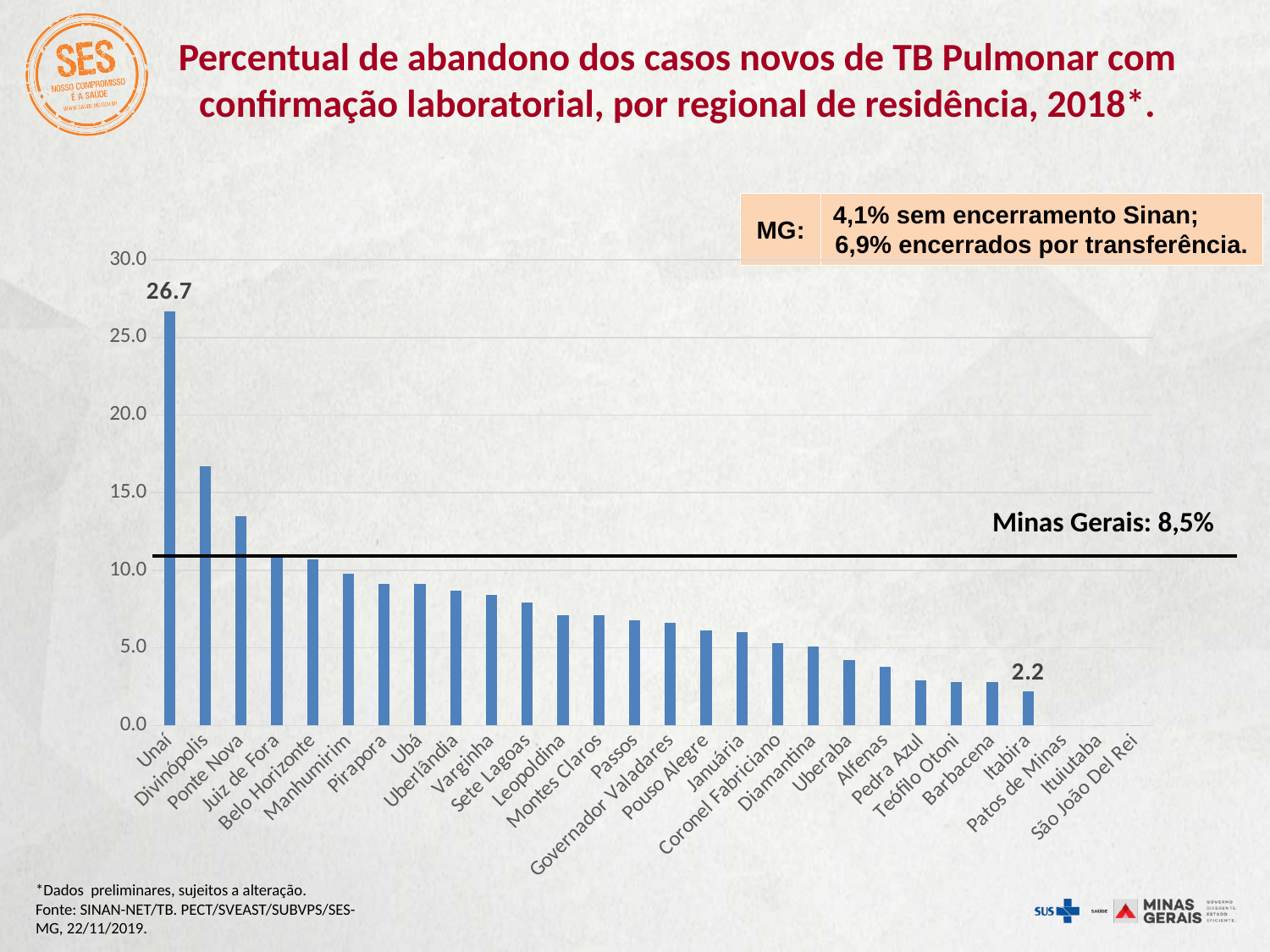
What kind of chart is shown on the slide? bar chart What value is given for Minas Gerais by the horizontal reference line? 8,5% How many regionals are listed on the x axis? 28 What is the difference between the values for Unaí and Itabira? 24.5 What is the value for Unaí? 26.7 Do the values rise or fall from left to right along the x axis? fall Which regional has the highest percentage of abandonment? Unaí Is the value for Divinópolis greater or less than 15.0? greater What is the value for Itabira? 2.2 Is the value for Ponte Nova greater or less than 10.0? greater Is the value for Uberaba greater or less than 5.0? less Which has a larger value, Divinópolis or Ponte Nova? Divinópolis